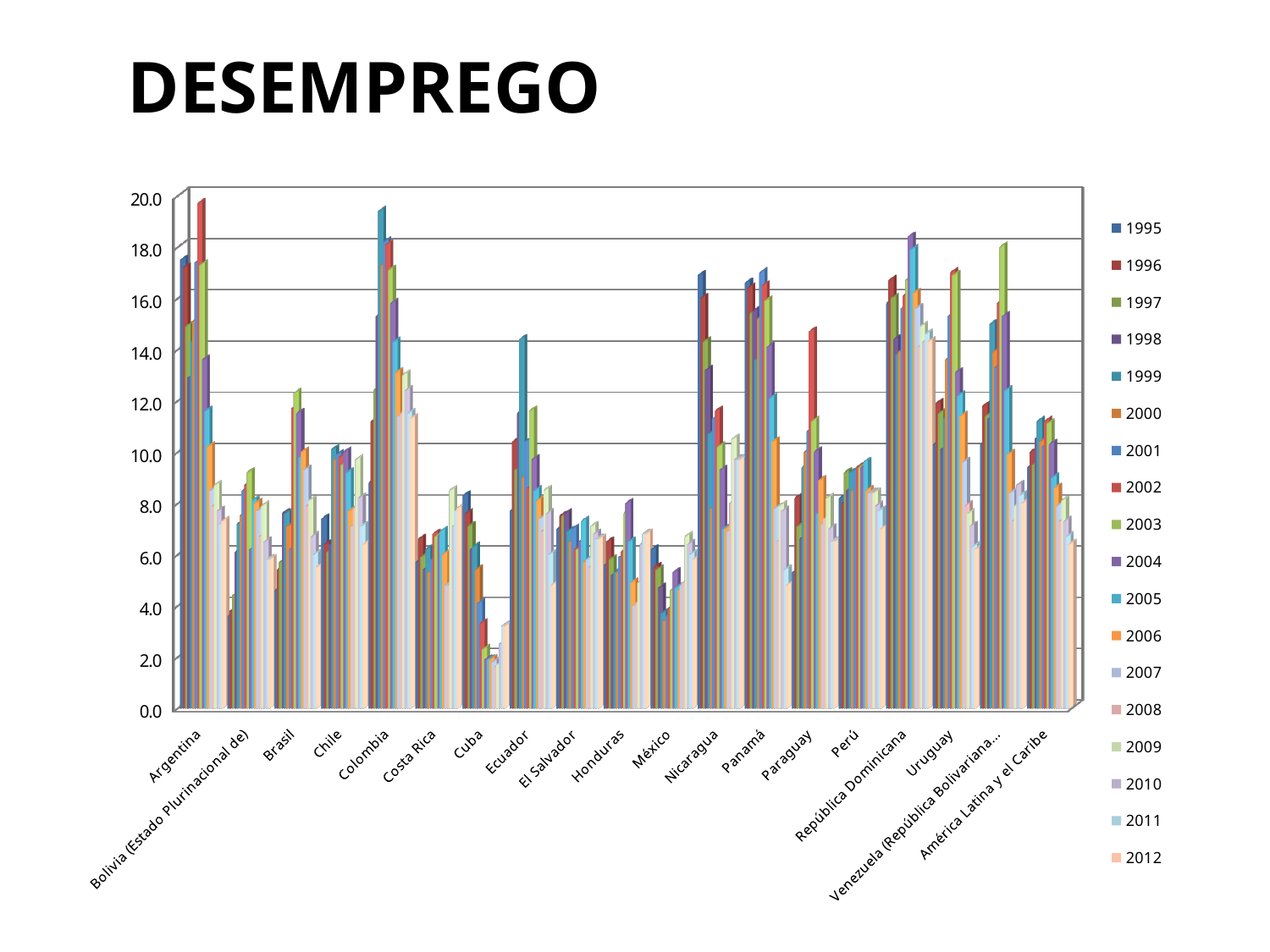
What is the title of the chart? DESEMPREGO Is the value for Colombia in 1999 greater or less than 16.0? greater Which is larger, the 1999 value for Colombia or the 1999 value for México? Colombia Which country has the lowest bars overall across the years? Cuba Is the value for Argentina in 2002 greater or less than 16.0? greater Is the value for Honduras in 2012 greater or less than 10.0? less How many series does the legend list? 18 Which is larger, the 2002 value for Argentina or the 2002 value for Cuba? Argentina How many countries or regions are shown along the x axis? 19 What kind of chart is shown on the slide? bar chart Which years are the first and last entries in the legend? 1995 and 2012